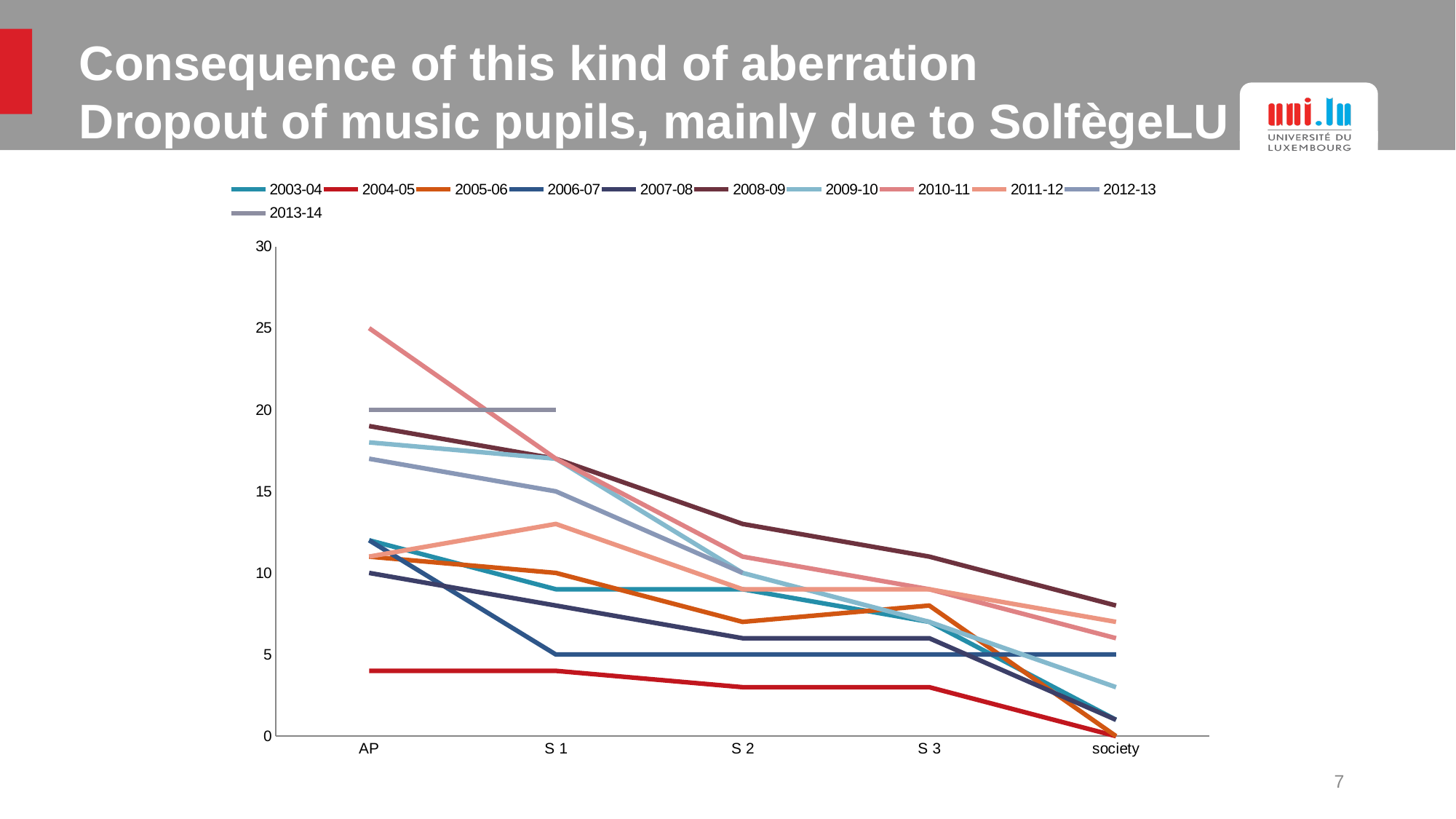
How many series does the legend list? 11 What is the value for 2010-11 at AP? 25 What is the value for 2006-07 at society? 5 What kind of chart is shown on the slide? line chart Does the 2008-09 series rise or fall from AP to society? fall Which series has the highest value at AP? 2010-11 Which series has the lowest value at AP? 2004-05 Is the value for 2008-09 at S 2 greater or less than 10? greater What is the value for 2013-14 at AP? 20 At S 1, which is larger: 2013-14 or 2004-05? 2013-14 How many categories are on the x axis? 5 What is the value for 2005-06 at society? 0